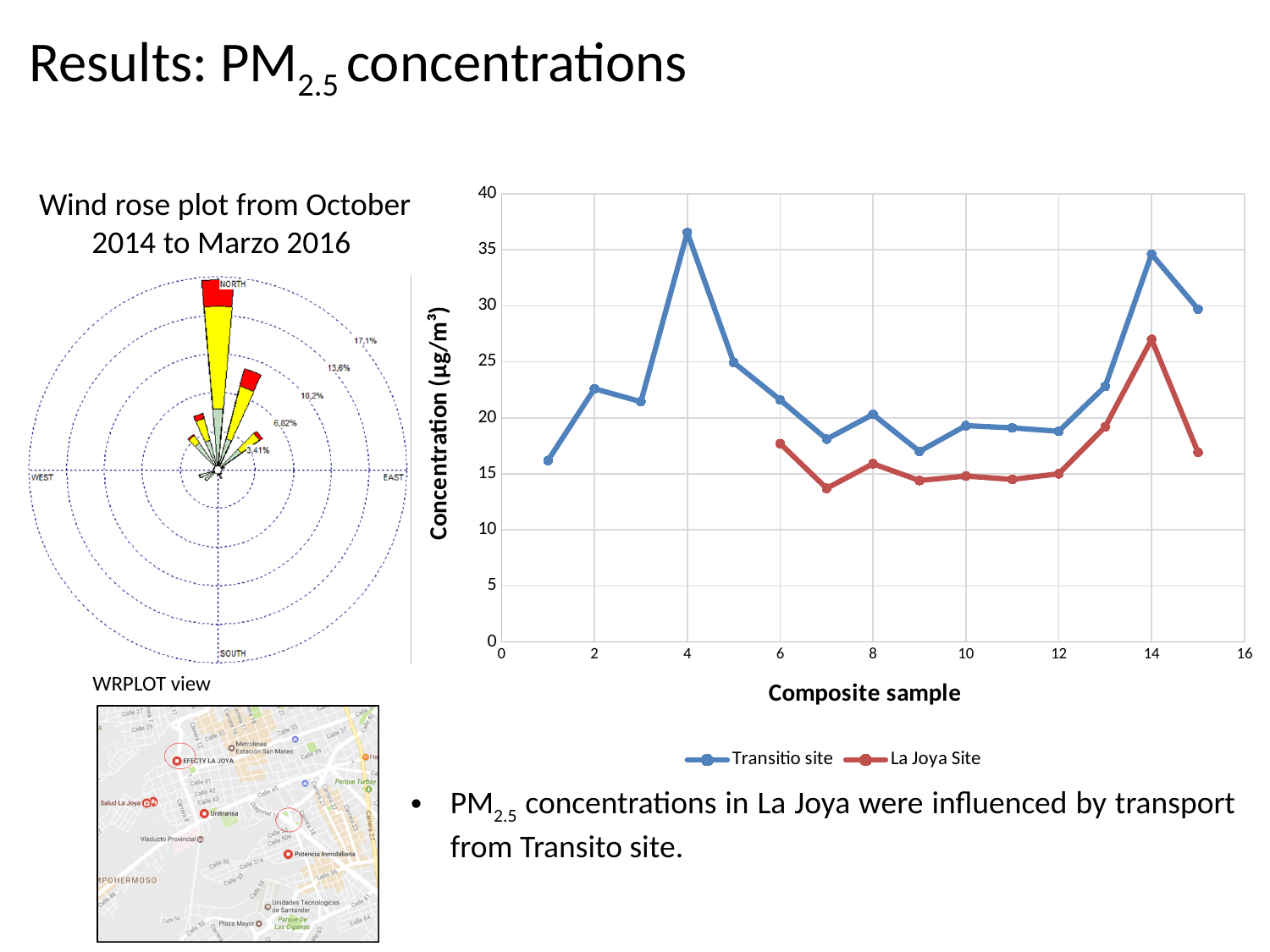
What is the y-axis title of the line chart? Concentration (µg/m³) Is the Transitio site value at composite sample 1 greater or less than 20? less How many data points are plotted for the La Joya Site series? 10 At composite sample 14, which series has the larger value, Transitio site or La Joya Site? Transitio site Does the La Joya Site series rise or fall between composite sample 12 and composite sample 14? rise What kind of chart is shown on the right of the slide? line chart What are the two series named in the legend of the line chart? Transitio site and La Joya Site How many series does the legend of the line chart list? 2 Is the La Joya Site value at composite sample 14 greater or less than 25? greater At which composite sample does the Transitio site series reach its highest value? 4 At which composite sample does the La Joya Site series reach its highest value? 14 Is the Transitio site value at composite sample 4 greater or less than 35? greater